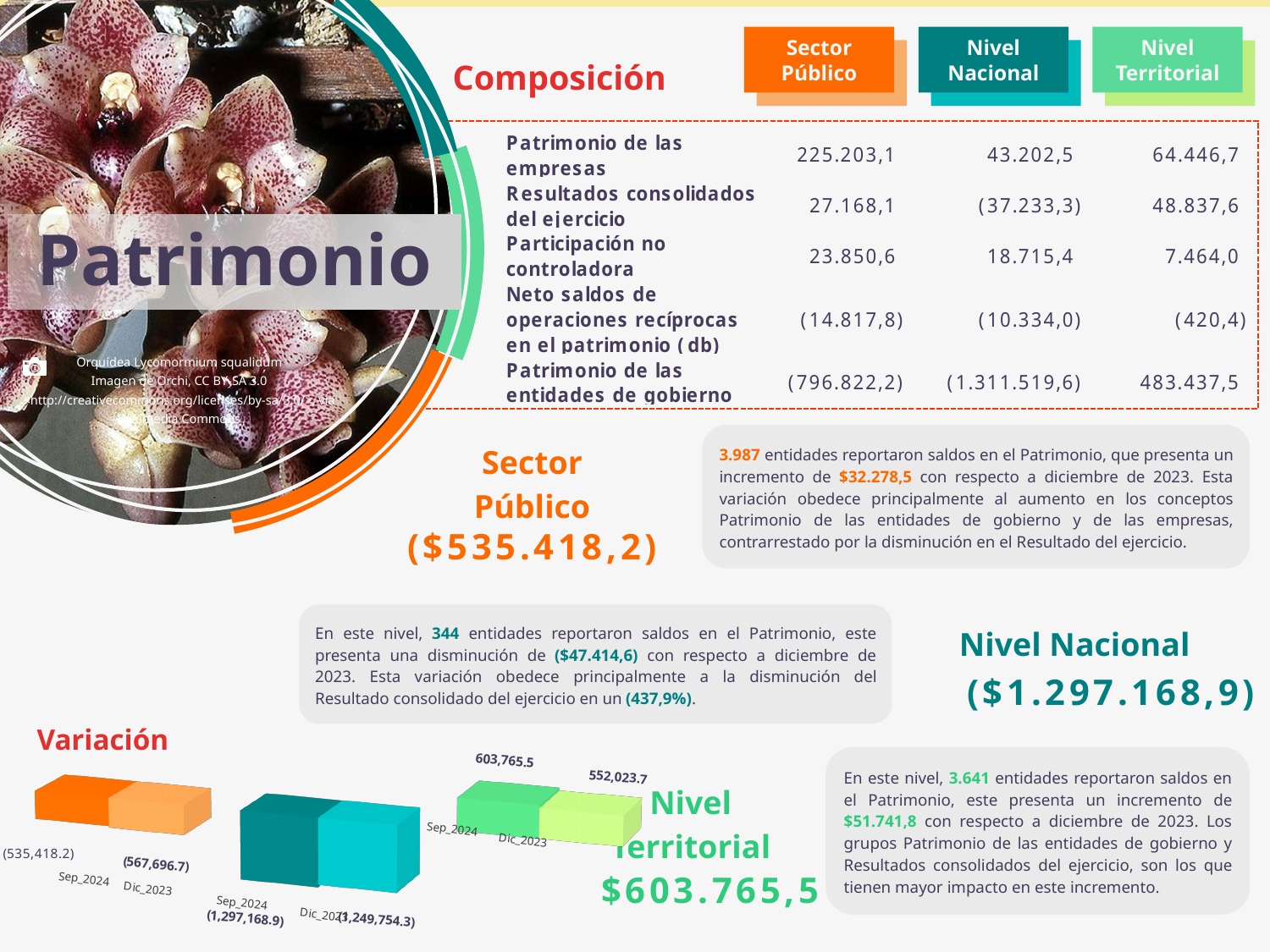
What are the two period labels on the x axis of the Variación charts? Sep_2024 and Dic_2023 In the teal Variación chart (middle), what is the value for Sep_2024? (1,297,168.9) How many periods (bars) does each Variación chart show? 2 In the Variación section, what kind of charts are shown? Bar charts In the orange Variación chart (leftmost), what is the difference between the Dic_2023 and Sep_2024 values? 32,278.5 In the orange Variación chart (leftmost), what is the value for Sep_2024? (535,418.2) In the green Variación chart (rightmost), which period has the higher value, Sep_2024 or Dic_2023? Sep_2024 In the orange Variación chart (leftmost), what is the value for Dic_2023? (567,696.7) In the green Variación chart (rightmost), what is the value for Dic_2023? 552,023.7 In the green Variación chart (rightmost), what is the value for Sep_2024? 603,765.5 In the green Variación chart (rightmost), what is the difference between the Sep_2024 and Dic_2023 values? 51,741.8 In the teal Variación chart (middle), what is the value for Dic_2023? (1,249,754.3)